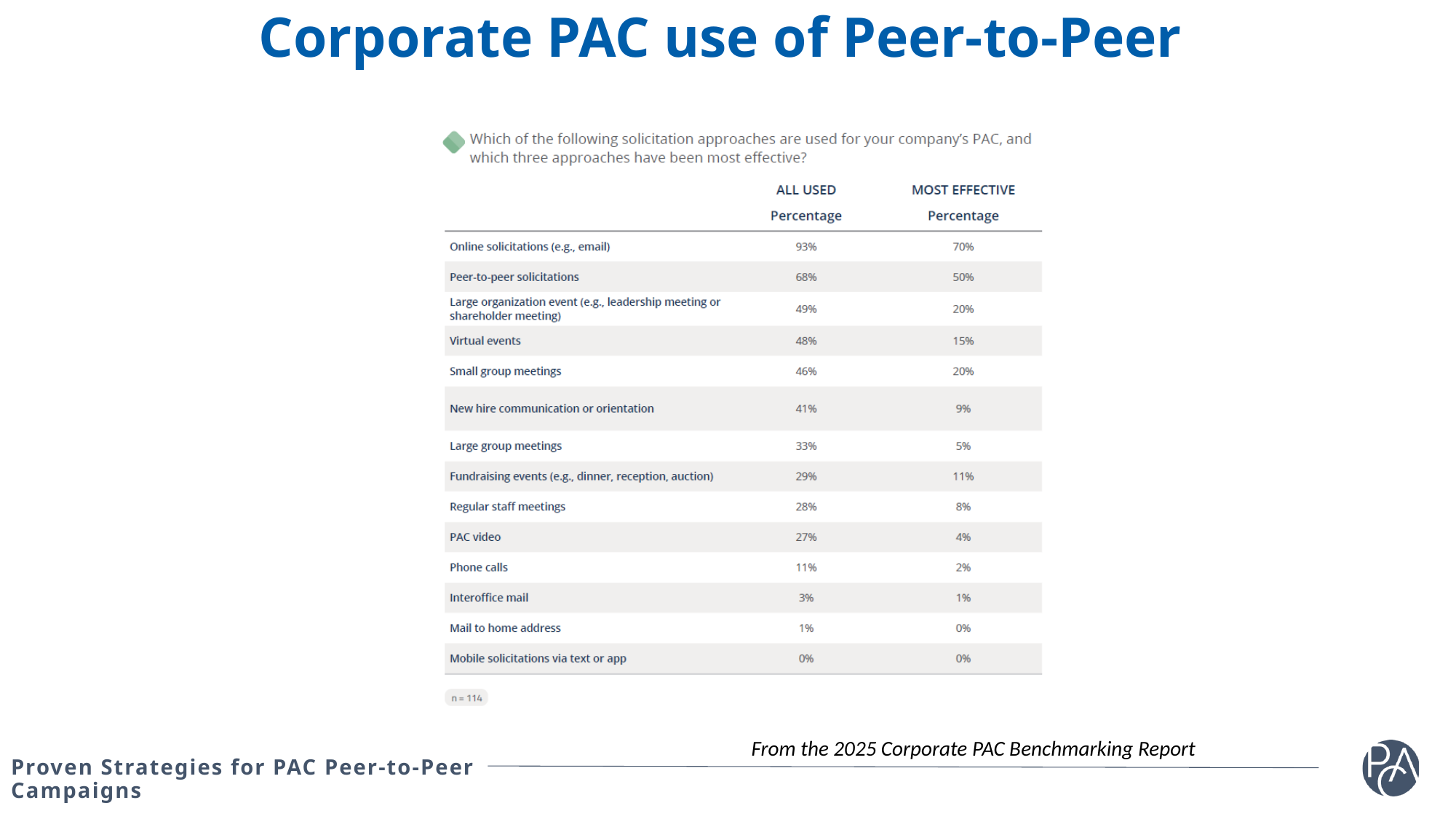
Which solicitation approach has the highest ALL USED percentage? Online solicitations (e.g., email) What is the difference between the ALL USED and MOST EFFECTIVE percentages for Peer-to-peer solicitations? 18% Which solicitation approach has the lowest ALL USED percentage? Mobile solicitations via text or app What is the sample size (n) shown below the table? n = 114 What is the ALL USED percentage for Peer-to-peer solicitations? 68% What is the difference in ALL USED percentage between Online solicitations (e.g., email) and Peer-to-peer solicitations? 25% What is the MOST EFFECTIVE percentage for Fundraising events (e.g., dinner, reception, auction)? 11% What is the MOST EFFECTIVE percentage for Online solicitations (e.g., email)? 70% How many percentage columns does the table have? 2 What is the ALL USED percentage for Virtual events? 48% How many solicitation approaches are listed in the table? 14 Which has a higher MOST EFFECTIVE percentage, Small group meetings or Large group meetings? Small group meetings